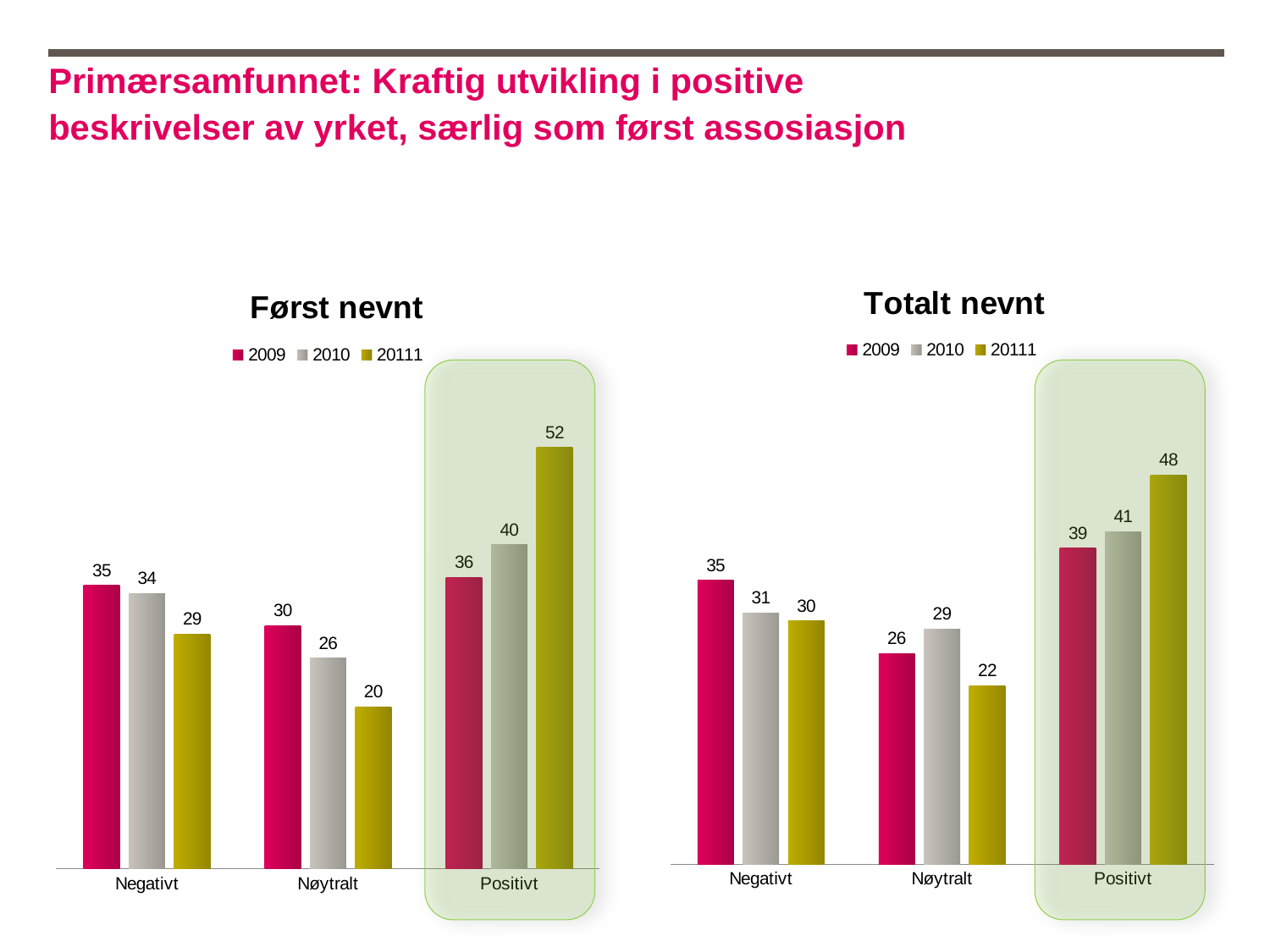
In the 'Først nevnt' chart, what is the value for Positivt in 20111? 52 In the 'Først nevnt' chart, how many categories are shown on the x axis? 3 In the 'Først nevnt' chart, what is the difference between the 20111 and 2009 values for Positivt? 16 What kind of chart is 'Først nevnt'? Bar chart In the 'Totalt nevnt' chart, how many series does the legend list? 3 In the 'Totalt nevnt' chart, which is larger for Nøytralt: the 2009 value or the 2010 value? 2010 In the 'Totalt nevnt' chart, what is the difference between the 2009 and 20111 values for Negativt? 5 In the 'Totalt nevnt' chart, what is the value for Nøytralt in 2010? 29 In the 'Først nevnt' chart, do the values for Negativt rise or fall from 2009 to 20111? Fall In the 'Først nevnt' chart, which category has the highest value for 2009? Positivt What is the title of the chart on the right side of the slide? Totalt nevnt In the 'Totalt nevnt' chart, which category has the lowest value for 20111? Nøytralt